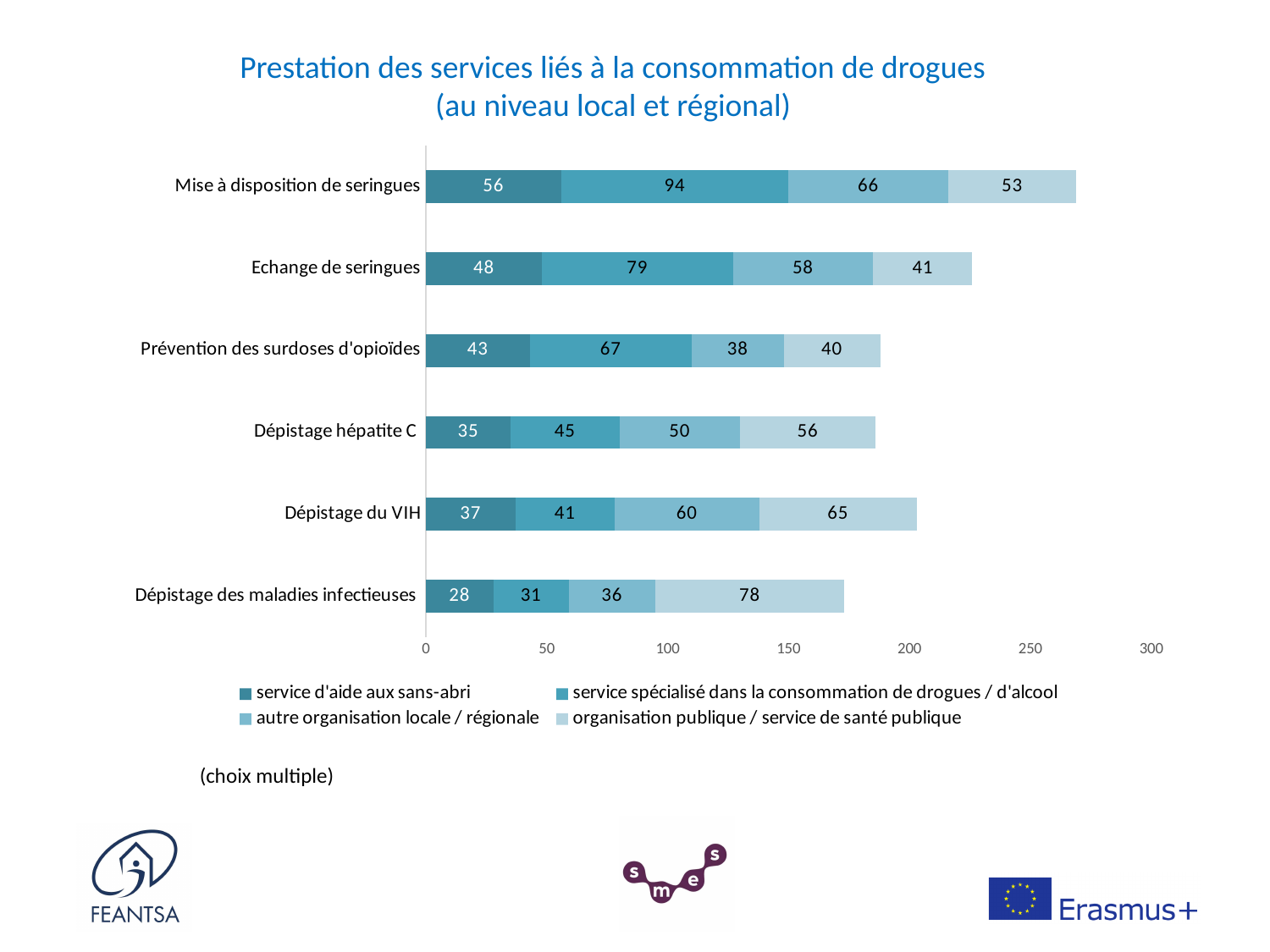
What type of chart is shown on the slide? stacked bar chart What is the value for 'service d'aide aux sans-abri' in the 'Prévention des surdoses d'opioïdes' bar? 43 Which category has the highest value for 'service d'aide aux sans-abri'? Mise à disposition de seringues What is the total of the stacked bar for 'Mise à disposition de seringues'? 269 What is the value for 'organisation publique / service de santé publique' in the 'Dépistage des maladies infectieuses' bar? 78 What is the total of the stacked bar for 'Dépistage du VIH'? 203 Which category has the lowest value for 'service spécialisé dans la consommation de drogues / d'alcool'? Dépistage des maladies infectieuses How many categories are plotted on the chart? 6 Which is larger: the 'organisation publique / service de santé publique' value for 'Dépistage du VIH' or for 'Dépistage hépatite C'? Dépistage du VIH How many series does the legend list? 4 What is the value for 'service spécialisé dans la consommation de drogues / d'alcool' in the 'Mise à disposition de seringues' bar? 94 What is the difference between the 'autre organisation locale / régionale' values for 'Mise à disposition de seringues' and 'Echange de seringues'? 8